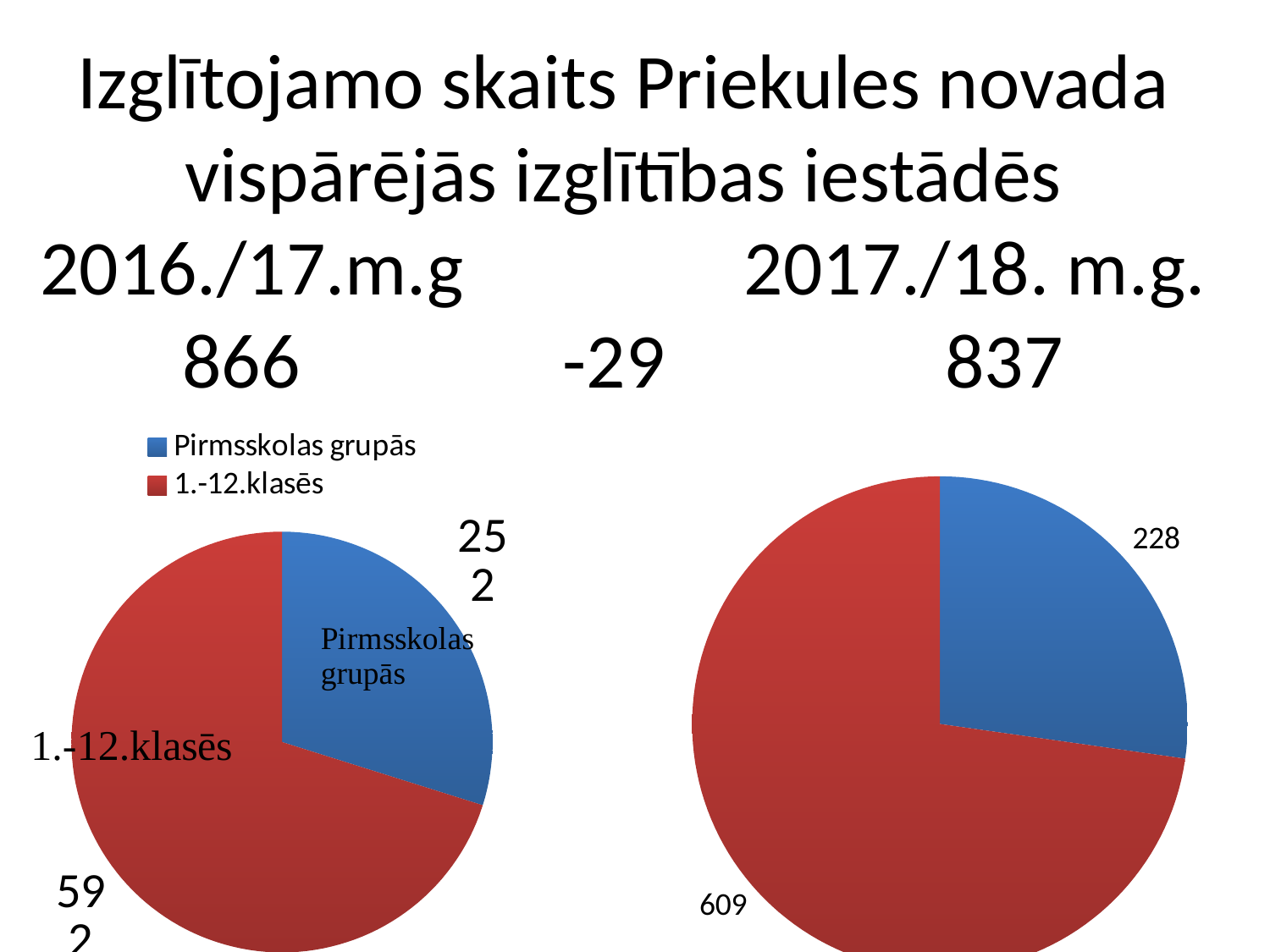
In the 2017./18. m.g. pie chart (right), which category has the largest slice? 1.-12.klasēs How many entries does the legend on the slide list? 2 What kind of chart is used on the slide for the 2016./17.m.g and 2017./18. m.g. data? pie chart In the 2016./17.m.g pie chart (left), which category has the larger slice, Pirmsskolas grupās or 1.-12.klasēs? 1.-12.klasēs In the 2016./17.m.g pie chart (left), what is the value for 1.-12.klasēs? 592 How many slices does the 2017./18. m.g. pie chart (right) have? 2 In the 2016./17.m.g pie chart (left), what is the value for Pirmsskolas grupās? 252 What colour is the 1.-12.klasēs slice in the pie charts? red In the 2017./18. m.g. pie chart (right), which category has the smallest slice? Pirmsskolas grupās In the 2017./18. m.g. pie chart (right), what is the value for Pirmsskolas grupās? 228 In the 2017./18. m.g. pie chart (right), what is the value for 1.-12.klasēs? 609 In the 2017./18. m.g. pie chart (right), what is the difference between the 1.-12.klasēs value and the Pirmsskolas grupās value? 381